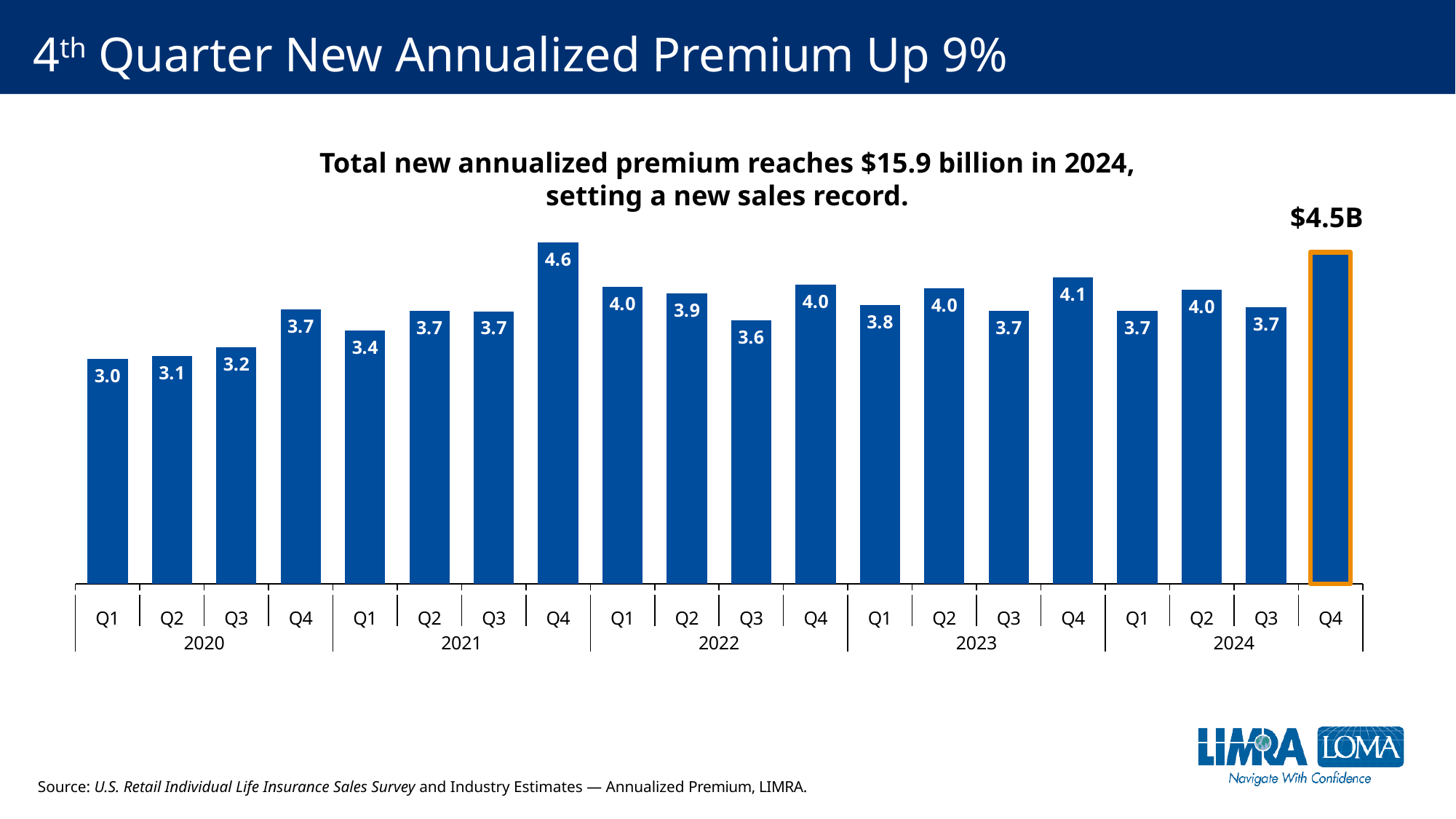
How many bars are plotted on the chart? 20 Which quarter has the highest value? Q4 2021 Do the values rise or fall from Q1 2020 to Q4 2020? Rise What kind of chart is shown on the slide? Bar chart What is the value for Q1 2020? 3.0 What is the value labelled on the Q4 2024 bar? $4.5B Which is larger, the value for Q4 2023 or the value for Q2 2023? Q4 2023 What is the chart's subtitle text above the bars? Total new annualized premium reaches $15.9 billion in 2024, setting a new sales record. What is the value for Q4 2021? 4.6 What is the difference between Q4 2021 and Q4 2020? 0.9 Which quarter has the lowest value? Q1 2020 What is the value for Q3 2022? 3.6